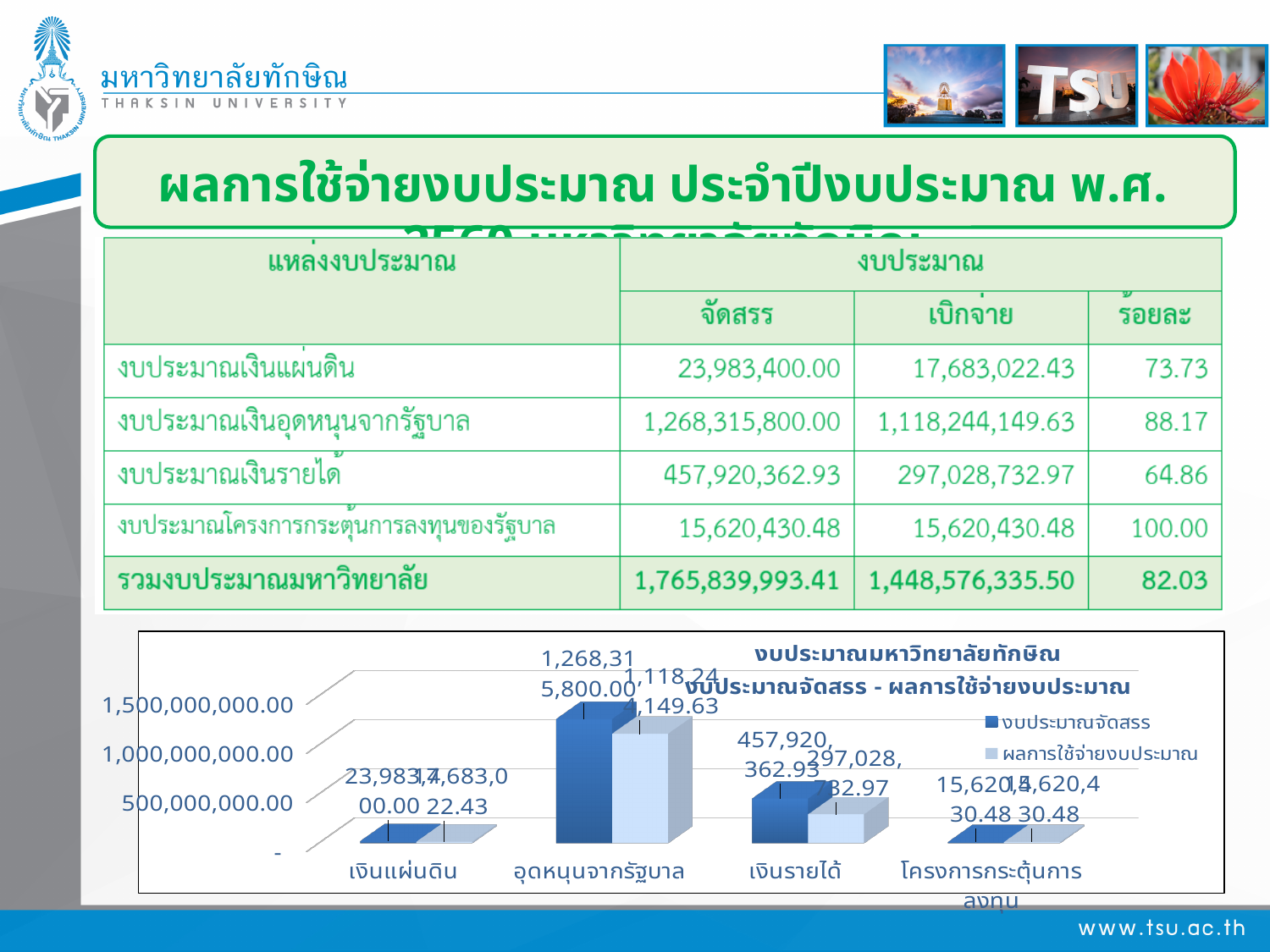
How many categories are shown on the x axis of the chart? 4 Is the งบประมาณจัดสรร value for อุดหนุนจากรัฐบาล greater or less than 1,000,000,000.00? greater Which category has the highest งบประมาณจัดสรร value in the chart? อุดหนุนจากรัฐบาล What is the value of ผลการใช้จ่ายงบประมาณ for โครงการกระตุ้นการลงทุน in the chart? 15,620,430.48 What is the value of ผลการใช้จ่ายงบประมาณ for เงินรายได้ in the chart? 297,028,732.97 Which category has the lowest งบประมาณจัดสรร value in the chart? โครงการกระตุ้นการลงทุน What type of chart is shown on the slide? Bar chart In the chart, what is the difference between งบประมาณจัดสรร and ผลการใช้จ่ายงบประมาณ for อุดหนุนจากรัฐบาล? 150,071,650.37 How many series does the chart legend list? 2 In the chart, which is larger for เงินรายได้: งบประมาณจัดสรร or ผลการใช้จ่ายงบประมาณ? งบประมาณจัดสรร What is the value of งบประมาณจัดสรร for อุดหนุนจากรัฐบาล in the chart? 1,268,315,800.00 Which colour represents งบประมาณจัดสรร in the chart legend? Dark blue